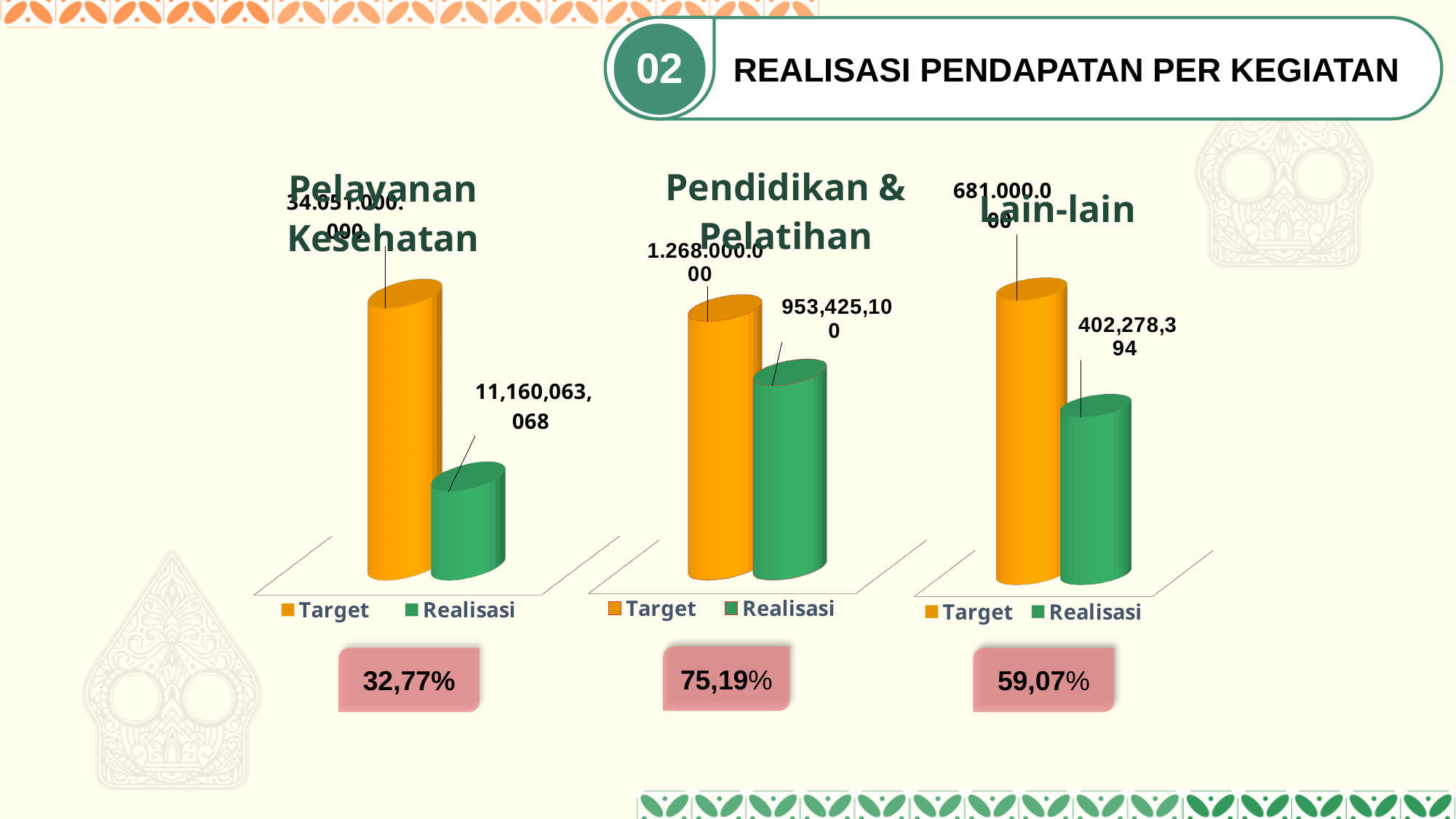
How many charts are shown on the slide? 3 In the Lain-lain chart, what is the value for Realisasi? 402,278,394 How many series does the legend of the Lain-lain chart list? 2 What kind of chart is the Pelayanan Kesehatan chart? Bar chart In the Lain-lain chart, which is larger, Target or Realisasi? Target In the Pendidikan & Pelatihan chart, what is the value for Target? 1.268.000.000 In the Pendidikan & Pelatihan chart, what colour are the Realisasi bars? Green What percentage is shown below the Pelayanan Kesehatan chart? 32,77% In the Pendidikan & Pelatihan chart, what is the value for Realisasi? 953,425,100 In the Pendidikan & Pelatihan chart, which series has the shorter bar? Realisasi In the Pelayanan Kesehatan chart, which series has the taller bar? Target In the Pelayanan Kesehatan chart, what is the value for Realisasi? 11,160,063,068